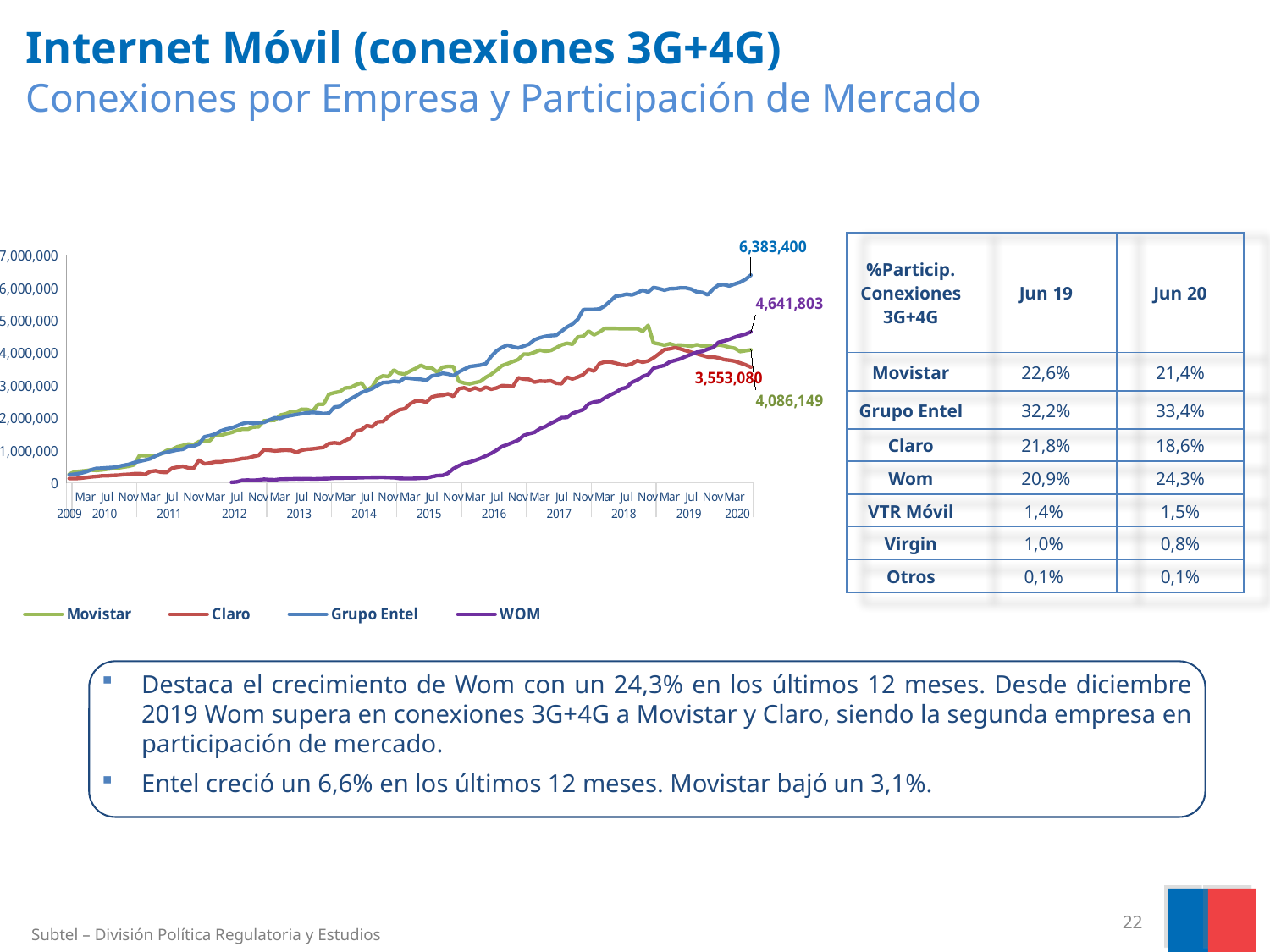
Which company has the highest number of connections at the end of the chart? Grupo Entel What is the final labelled value for Claro on the chart? 3,553,080 Is the final value for Grupo Entel greater or less than 6,000,000? greater How many series does the chart's legend list? 4 What is the final labelled value for Grupo Entel on the chart? 6,383,400 What is the final labelled value for WOM on the chart? 4,641,803 What is the difference between the final labelled values of Grupo Entel and WOM? 1,741,597 Which company has the lowest number of connections at the end of the chart? Claro What is the final labelled value for Movistar on the chart? 4,086,149 At the end of the chart, which is larger: the value for WOM or the value for Movistar? WOM Does the Grupo Entel line generally rise or fall from 2009 to 2020? rise What kind of chart is shown on the slide? line chart